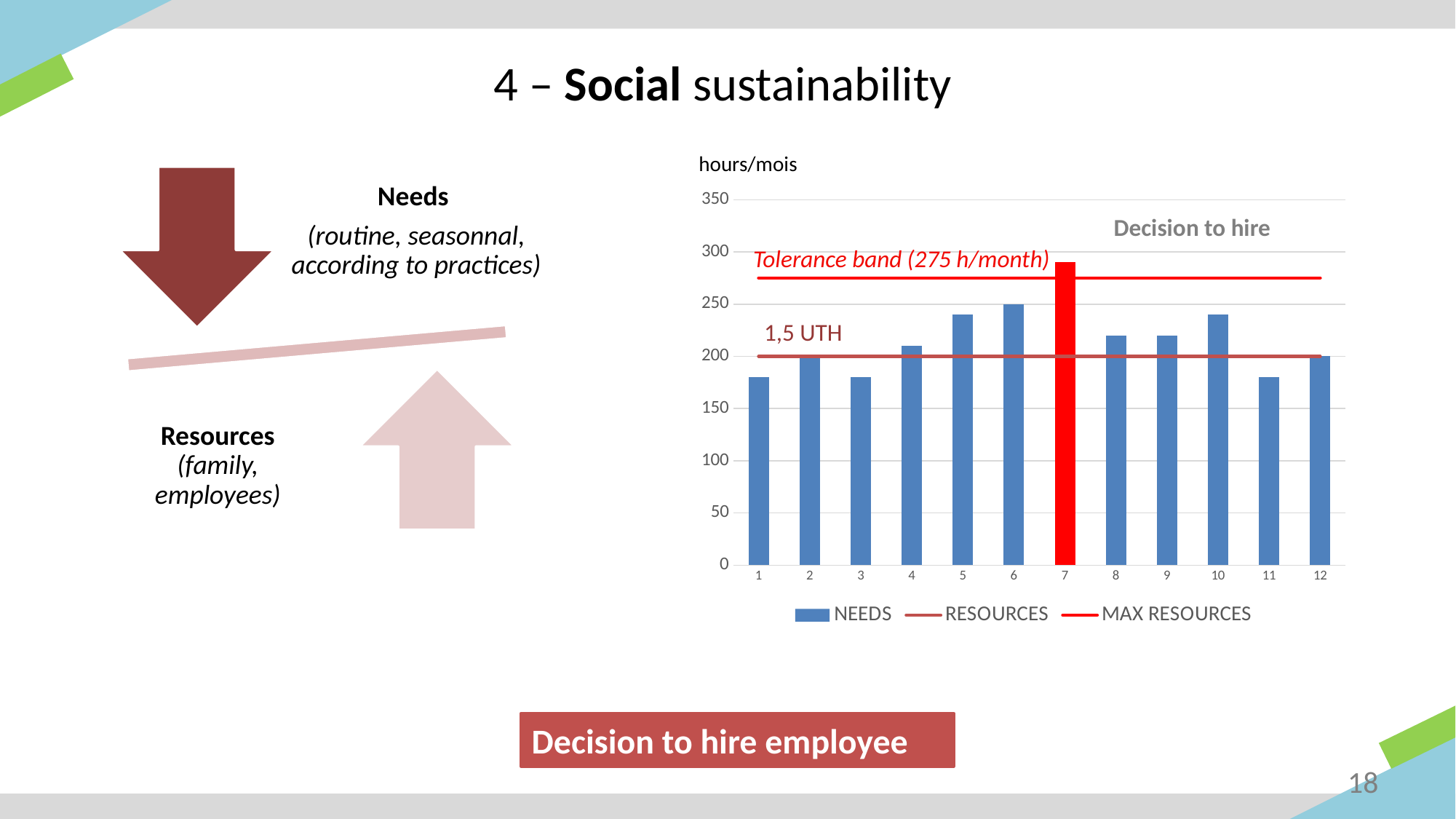
What kind of chart is shown on the slide? combination bar and line chart Which month has the larger NEEDS value, month 7 or month 1? 7 How many categories (months) are shown on the x axis of the chart? 12 Is the NEEDS value for month 5 greater or less than 200? greater How many series does the chart legend list? 3 What unit is shown above the y axis of the chart? hours/mois Is the NEEDS value for month 11 greater or less than 200? less What is the value of the MAX RESOURCES (tolerance band) line in the chart? 275 h/month Is the NEEDS value for month 7 greater or less than 250? greater Which month has the larger NEEDS value, month 5 or month 3? 5 Which month has the highest NEEDS value in the chart? 7